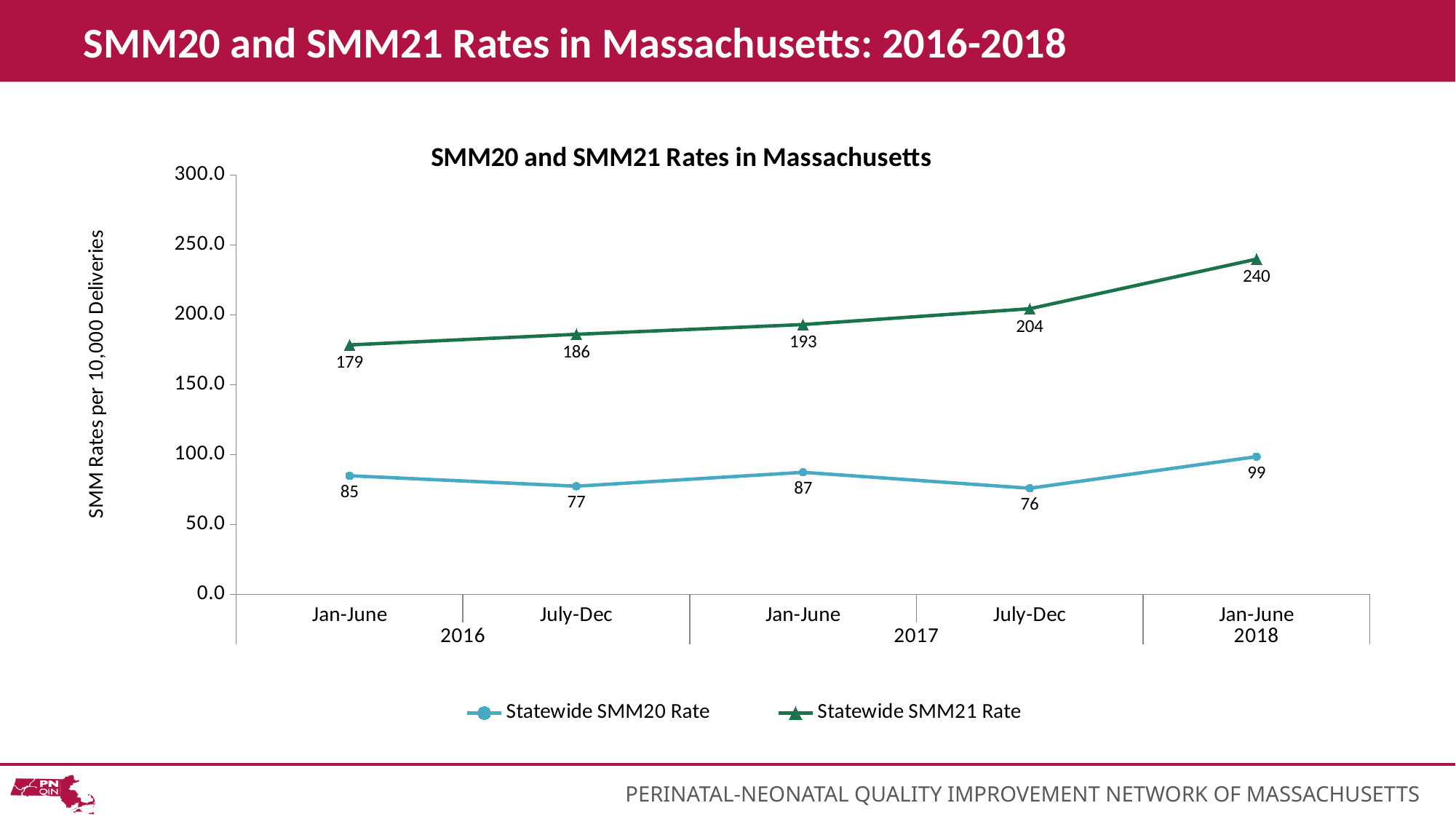
How many series does the legend list? 2 In which period is the Statewide SMM20 Rate lowest? July-Dec 2017 What is the Statewide SMM20 Rate for July-Dec 2016? 77 By how much did the Statewide SMM21 Rate increase from July-Dec 2017 to Jan-June 2018? 36 What is the Statewide SMM21 Rate for Jan-June 2016? 179 How many time periods are plotted on the x axis? 5 What kind of chart is shown on the slide? Line chart In which period is the Statewide SMM21 Rate highest? Jan-June 2018 Is the Statewide SMM21 Rate for July-Dec 2017 greater or less than 200? greater What is the Statewide SMM21 Rate for Jan-June 2018? 240 Which is larger, the Statewide SMM20 Rate in Jan-June 2017 or in July-Dec 2017? Jan-June 2017 What is the difference between the Statewide SMM21 Rate and the Statewide SMM20 Rate in Jan-June 2018? 141